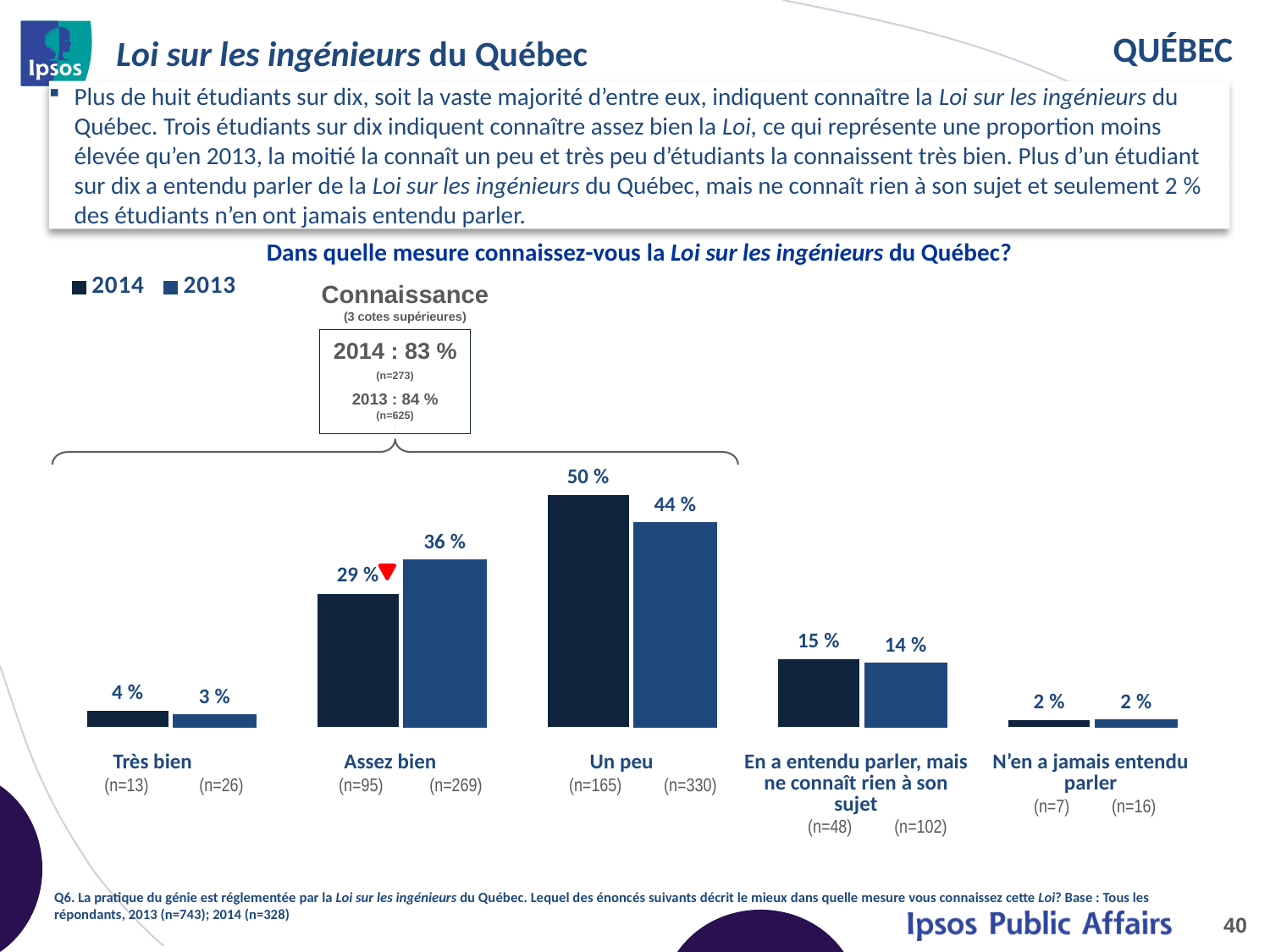
What is the 2013 value for "Assez bien"? 36 % How many series does the legend list? 2 What is the 2014 value for "En a entendu parler, mais ne connaît rien à son sujet"? 15 % What is the difference between the 2014 and 2013 values for "Un peu"? 6 % What is the "Connaissance (3 cotes supérieures)" value shown for 2014? 83 % What kind of chart is shown on the slide? Bar chart How many categories are shown on the x axis of the chart? 5 What is the 2014 value for "Un peu"? 50 % What is the difference between the 2013 and 2014 values for "Assez bien"? 7 % For "Très bien", which year has the larger value, 2014 or 2013? 2014 Which category has the highest 2014 value? Un peu Which category has the lowest 2013 value? N'en a jamais entendu parler